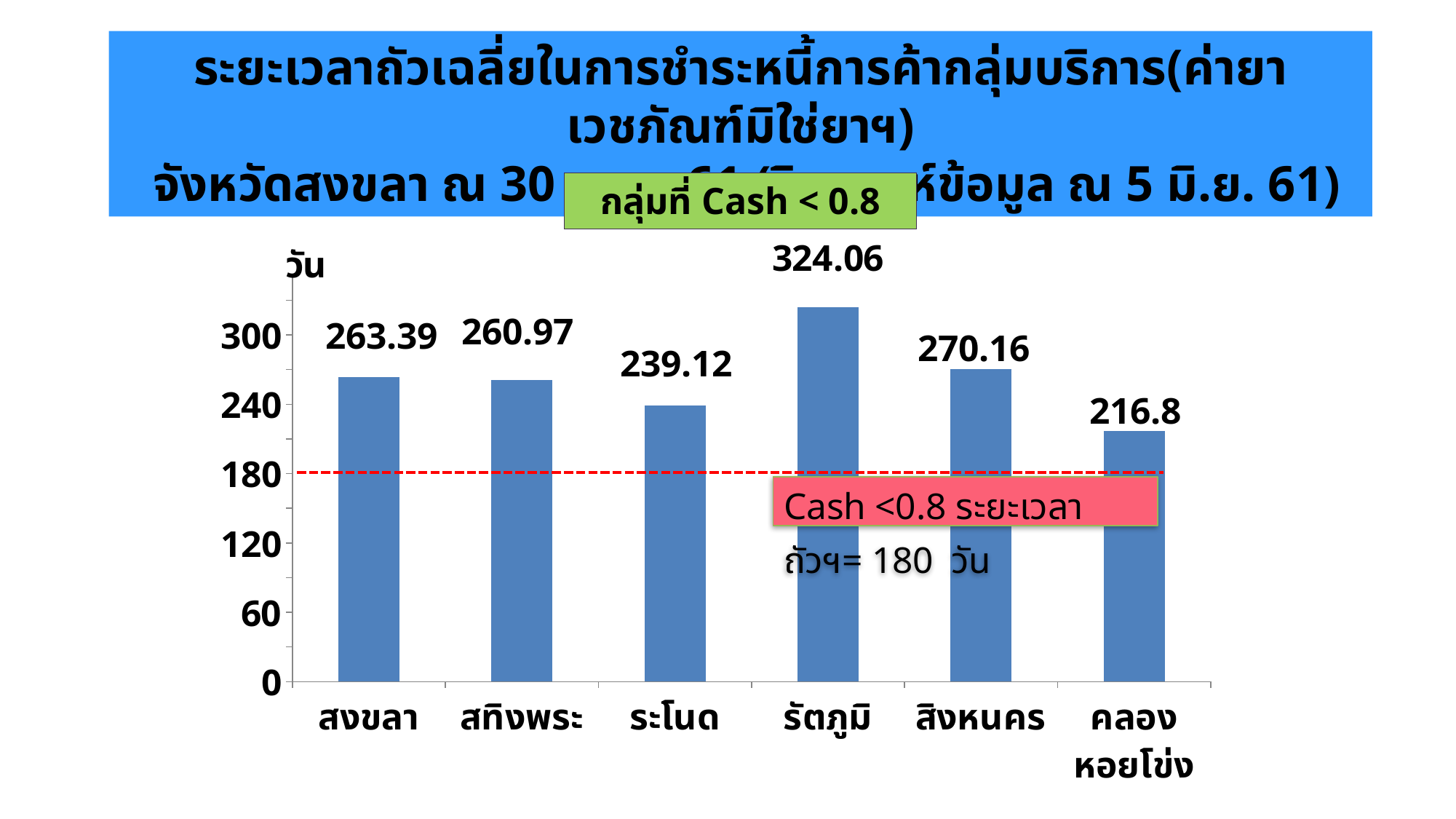
What is the value for คลองหอยโข่ง? 216.8 What is the difference between the values for รัตภูมิ and คลองหอยโข่ง? 107.26 What value does the red dashed reference line mark on the chart? 180 Which category has the highest value? รัตภูมิ What kind of chart is shown on the slide? bar chart What is the value for ระโนด? 239.12 How many categories are shown on the x axis? 6 Is the value for คลองหอยโข่ง greater or less than 180? greater What is the difference between the values for สงขลา and สทิงพระ? 2.42 What is the value for รัตภูมิ? 324.06 Which is larger, the value for สิงหนคร or the value for ระโนด? สิงหนคร Which category has the lowest value? คลองหอยโข่ง